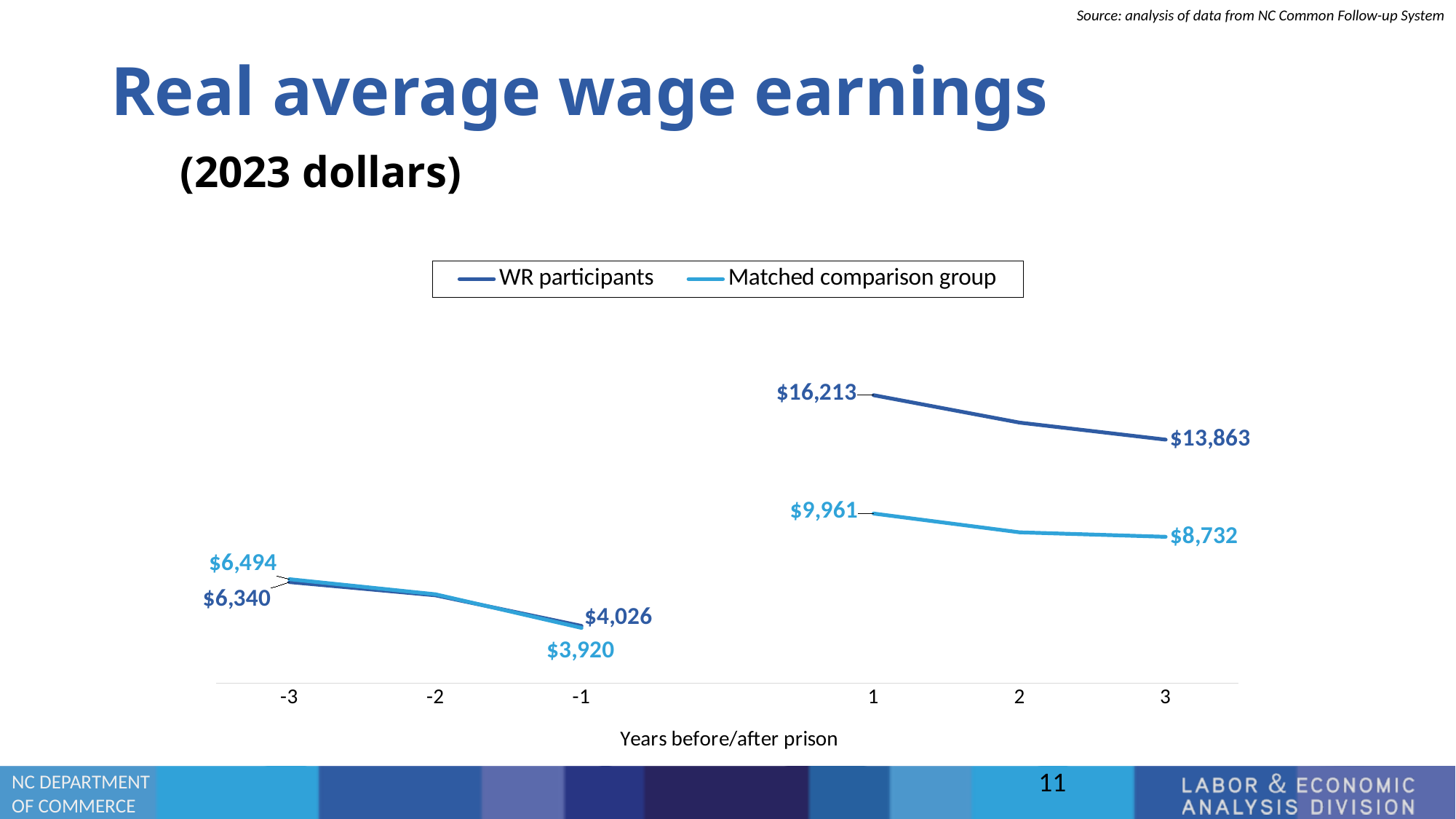
What kind of chart is shown on the slide? Line chart At year 3 after prison, which series has the higher value: WR participants or the Matched comparison group? WR participants What is the difference between WR participants and the Matched comparison group at year 1 after prison? $6,252 What is the value for WR participants at year -3 before prison? $6,340 What is the value for the Matched comparison group at year -1 before prison? $3,920 At year -3 before prison, which series has the higher labelled value: WR participants or the Matched comparison group? Matched comparison group Do the WR participants' values rise or fall from year 1 to year 3 after prison? Fall What is the value for the Matched comparison group at year 3 after prison? $8,732 What is the real average wage earnings value for WR participants at year 1 after prison? $16,213 What is the label of the x axis? Years before/after prison What is the difference between the WR participants' values at year 1 and year 3 after prison? $2,350 How many series does the legend list? 2